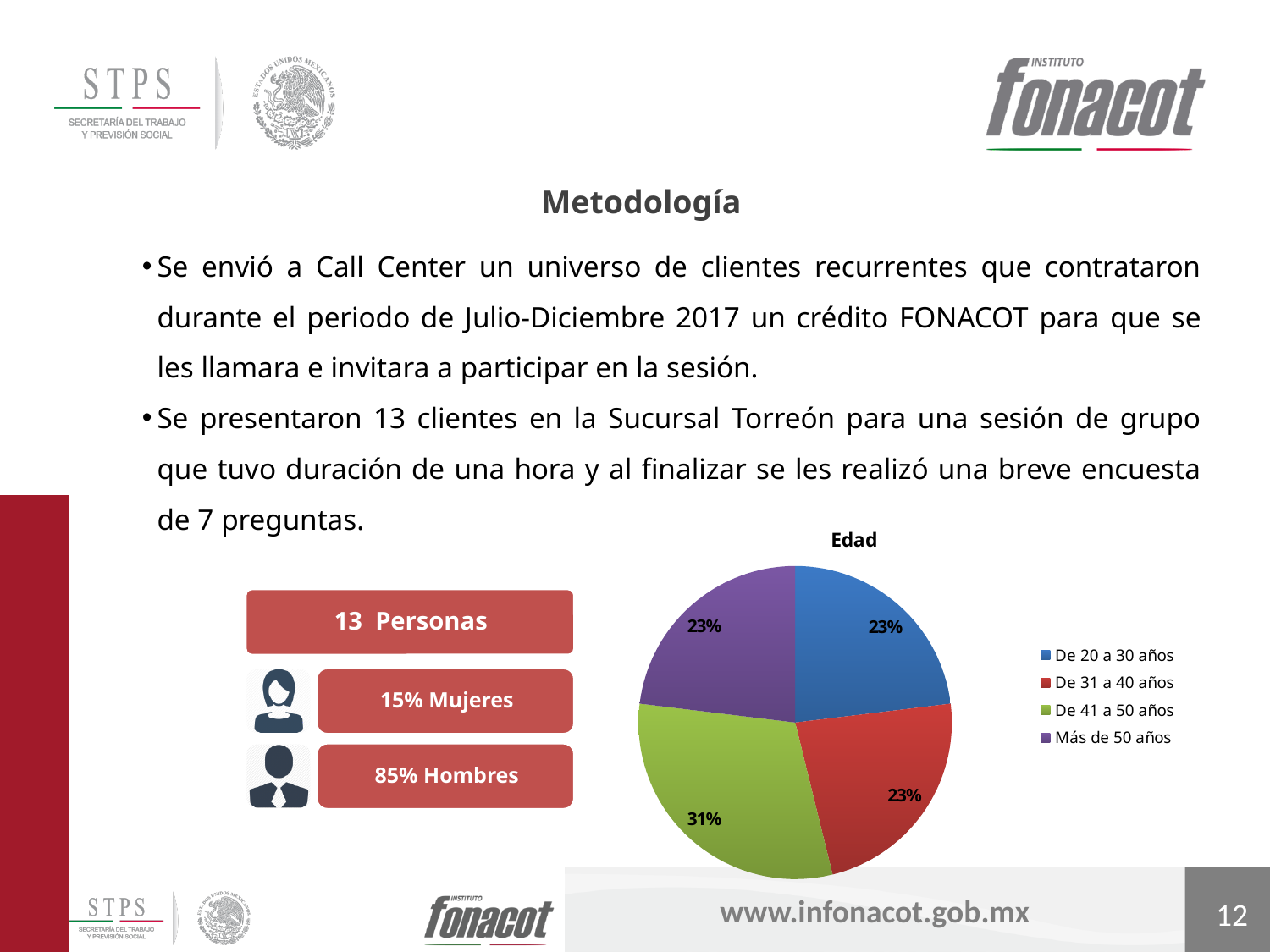
In the "Edad" pie chart, which slice is larger: "De 41 a 50 años" or "De 31 a 40 años"? De 41 a 50 años How many slices does the "Edad" pie chart have? 4 In the "Edad" pie chart, what colour is the slice for "De 41 a 50 años"? green In the "Edad" pie chart, what is the difference in percentage points between "De 41 a 50 años" and "Más de 50 años"? 8% How many entries does the legend of the "Edad" pie chart list? 4 What is the title of the pie chart on the slide? Edad In the "Edad" pie chart, what percentage corresponds to "De 41 a 50 años"? 31% In the "Edad" pie chart, what percentage corresponds to "De 31 a 40 años"? 23% What type of chart is shown under the title "Edad"? pie chart In the "Edad" pie chart, what percentage corresponds to "De 20 a 30 años"? 23% In the "Edad" pie chart, what percentage corresponds to "Más de 50 años"? 23% Which age group has the largest slice in the "Edad" pie chart? De 41 a 50 años